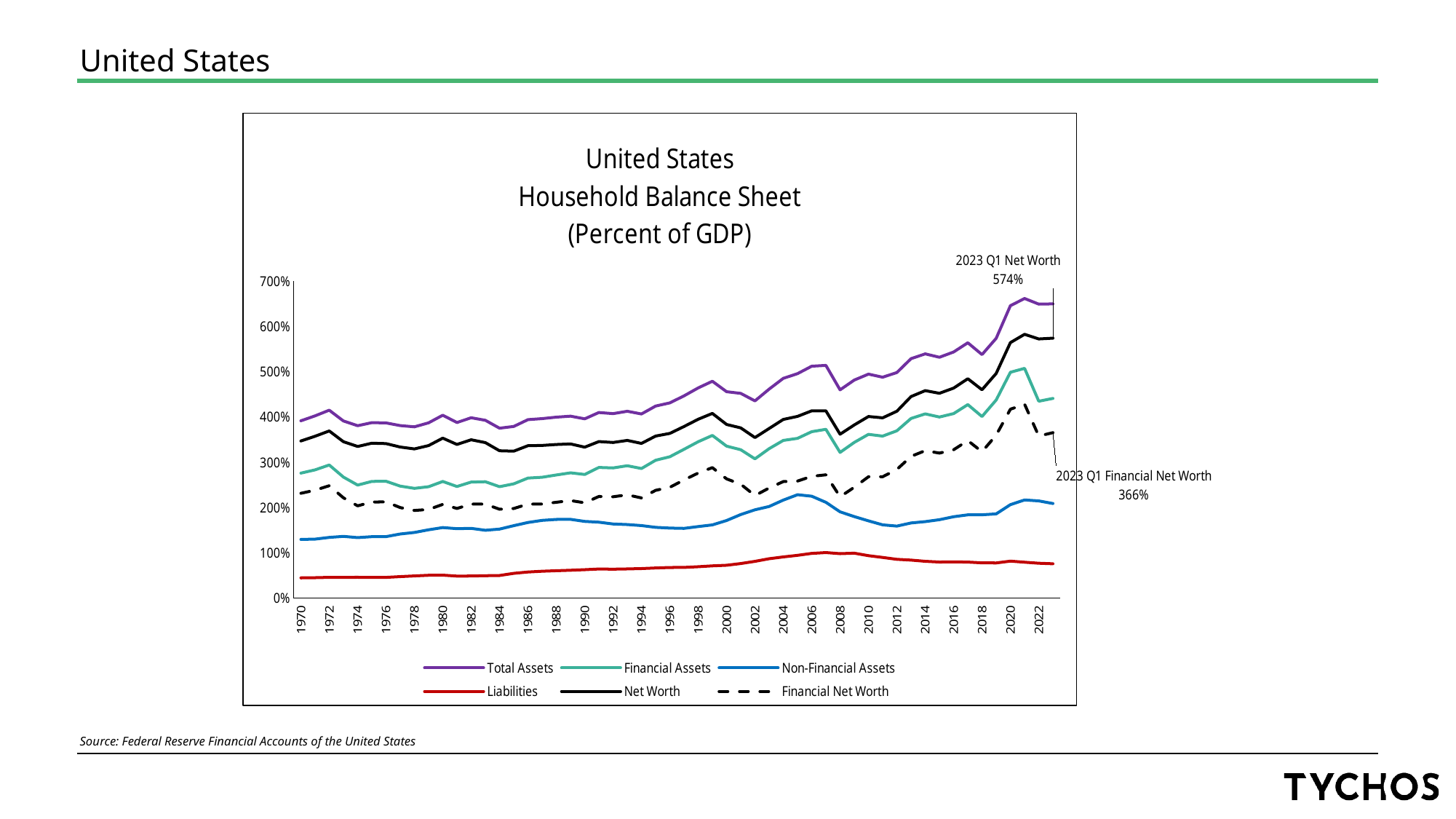
How many series does the legend list? 6 Which series is drawn with a dashed line? Financial Net Worth Which series has the highest values across the chart? Total Assets Is the value for Total Assets in 2020 greater or less than 600%? greater What is the 2023 Q1 Financial Net Worth value labelled on the chart? 366% What kind of chart is shown on the slide? line chart What is the 2023 Q1 Net Worth value labelled on the chart? 574% What is the difference between the labelled 2023 Q1 Net Worth and 2023 Q1 Financial Net Worth values? 208% Is the value for Liabilities in 1970 greater or less than 100%? less Is the value for Non-Financial Assets in 2005 greater or less than 300%? less Which series has the lowest values across the chart? Liabilities Does the Total Assets series generally rise or fall from 1970 to 2022? rise